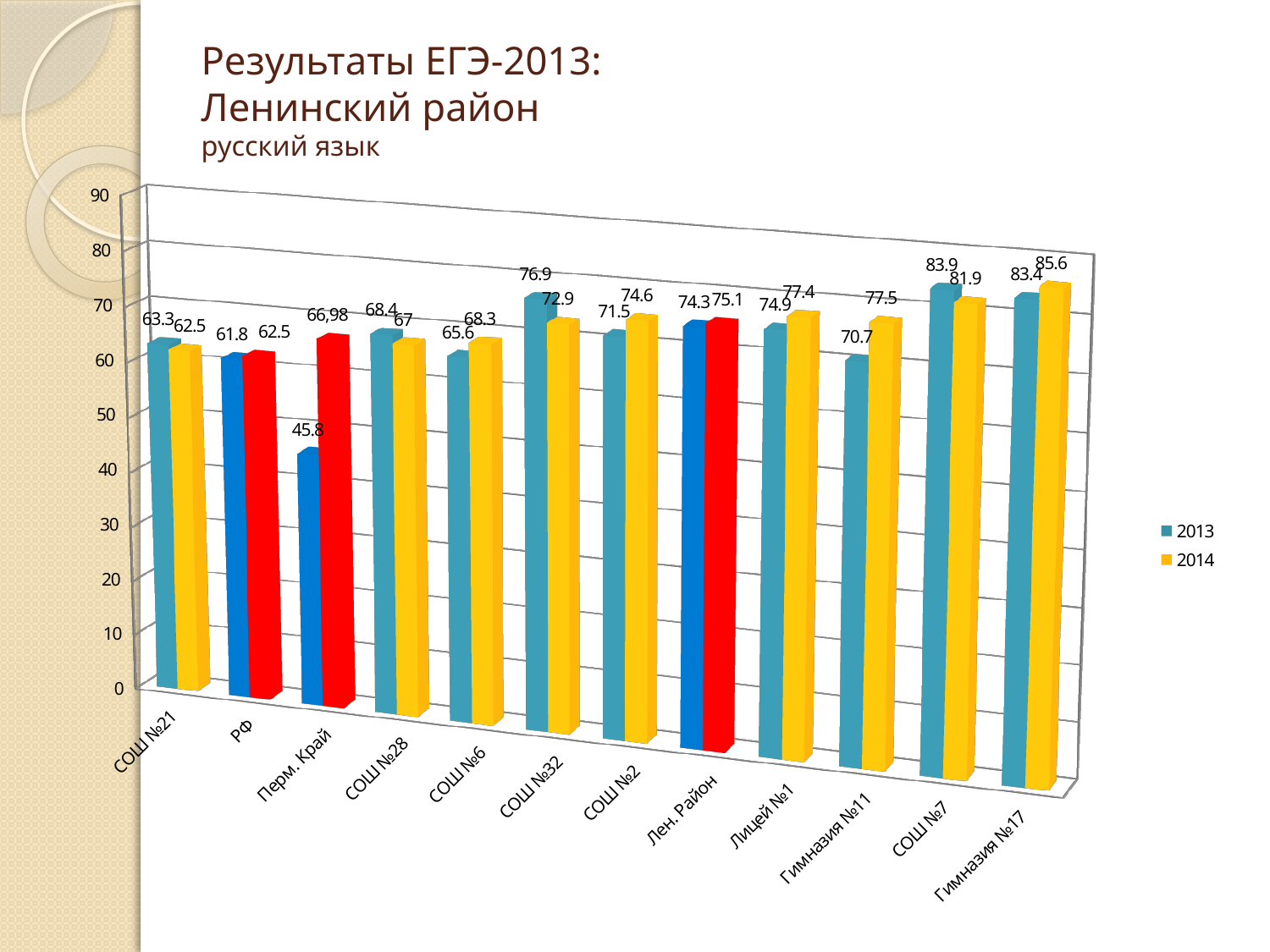
What is the 2013 value for СОШ №32? 76.9 How many categories are shown on the x axis? 12 What is the 2013 value for Перм. Край? 45.8 Which category has the lowest 2013 value? Перм. Край What is the 2014 value for Перм. Край? 66,98 For СОШ №32, which year has the larger value, 2013 or 2014? 2013 What kind of chart is shown on the slide? Bar chart What is the difference between the 2014 and 2013 values for Гимназия №11? 6.8 Which category has the highest 2014 value? Гимназия №17 What is the difference between the 2013 and 2014 values for СОШ №7? 2 What is the 2014 value for Гимназия №11? 77.5 How many series does the legend list? 2